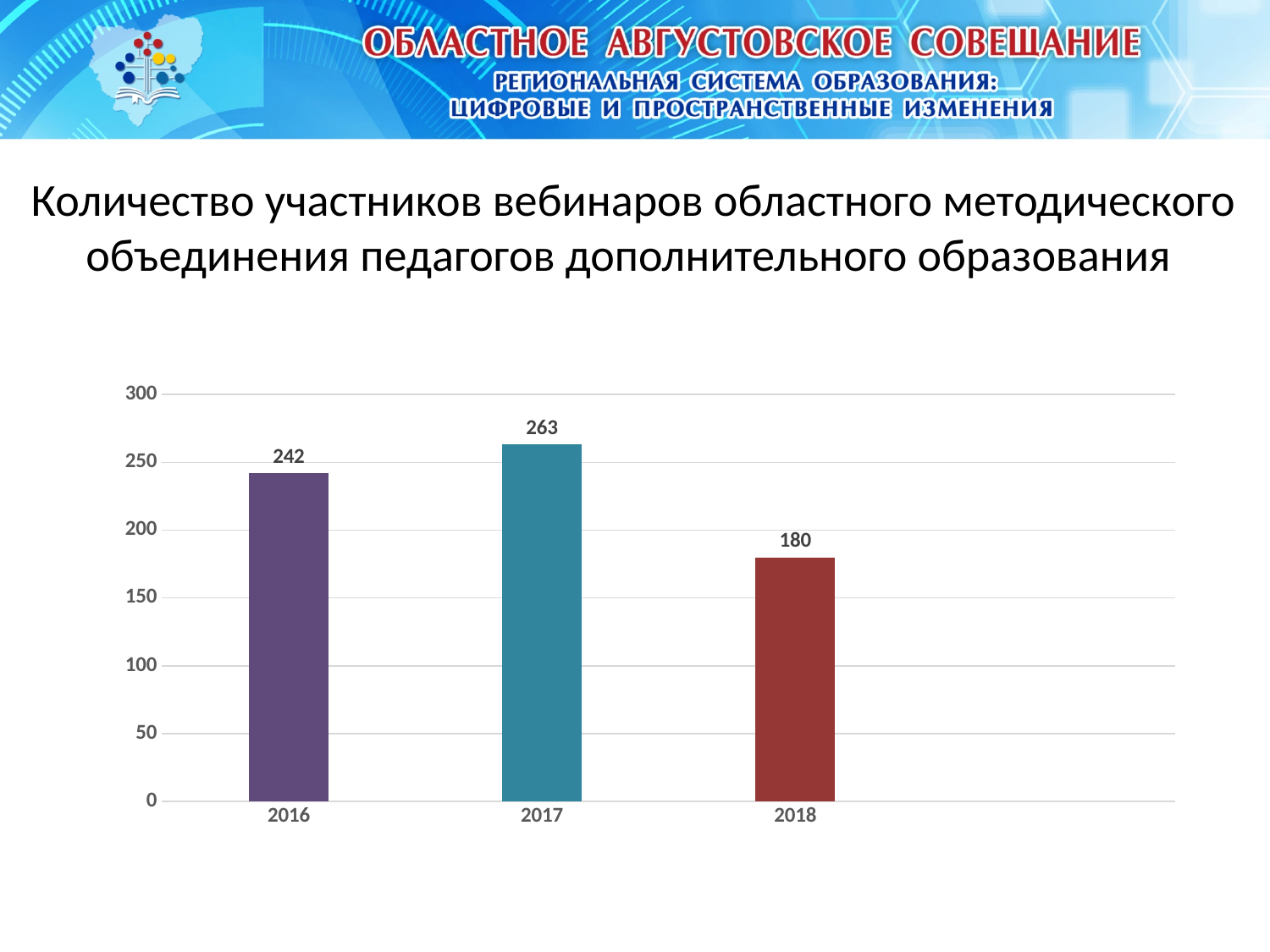
Does the value rise or fall from 2017 to 2018? fall What is the difference between the values for 2017 and 2016? 21 Which year has the lowest value? 2018 What is the difference between the values for 2017 and 2018? 83 What is the value for 2017? 263 What is the value for 2016? 242 Which year has the highest value? 2017 What is the value for 2018? 180 What kind of chart is shown on the slide? bar chart Which is larger, the value for 2016 or the value for 2018? 2016 How many years are shown on the chart? 3 Is the value for 2018 greater or less than 200? less